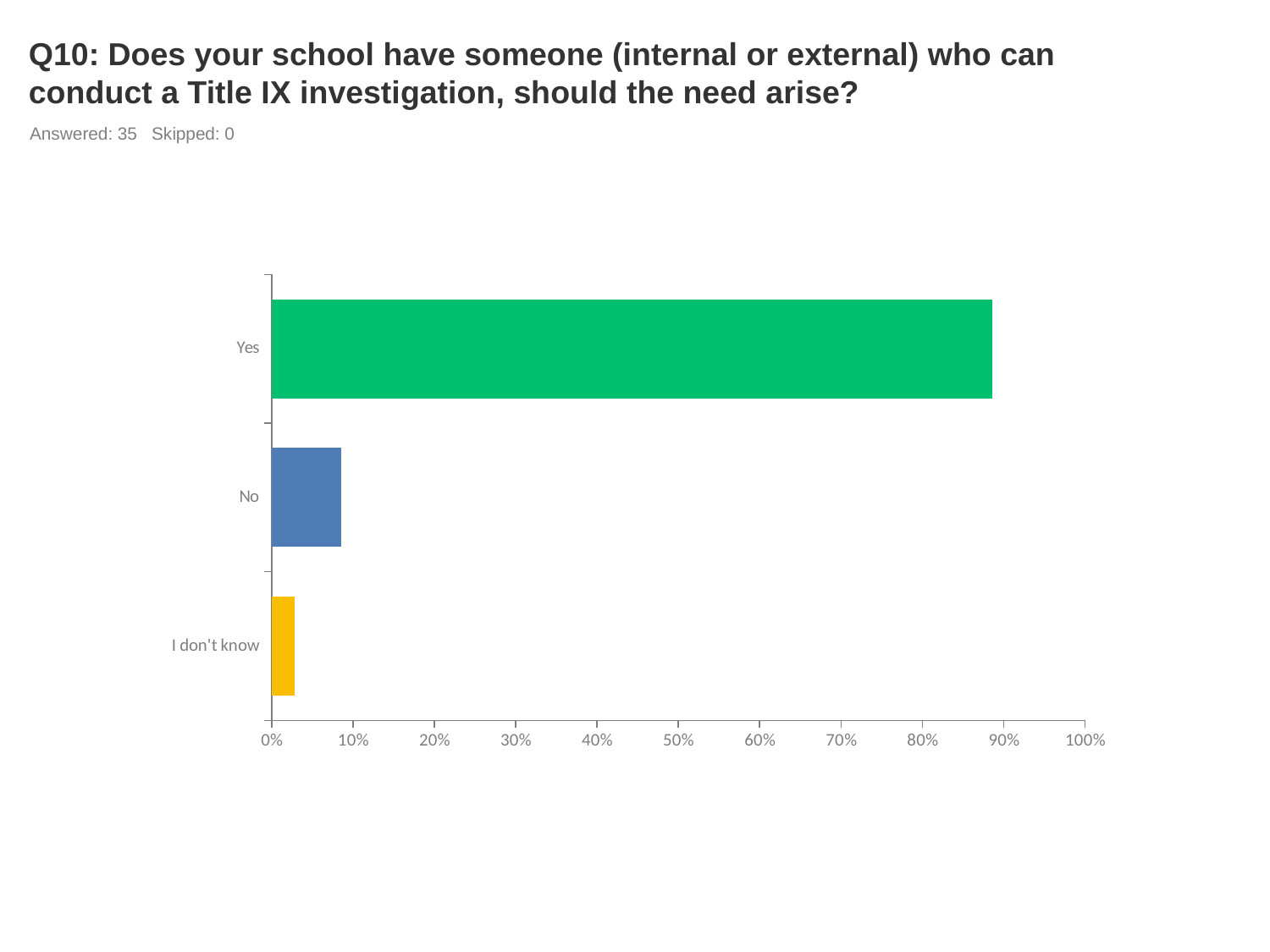
What kind of chart is shown on the slide? bar chart Is the value for I don't know greater or less than 10%? less How many respondents answered this question according to the slide? 35 Is the value for Yes greater or less than 80%? greater What colour is the bar for Yes? green Which category has the highest value? Yes How many categories are plotted in the chart? 3 Which category has the lowest value? I don't know Which is larger, the value for No or the value for I don't know? No Which is larger, the value for Yes or the value for No? Yes